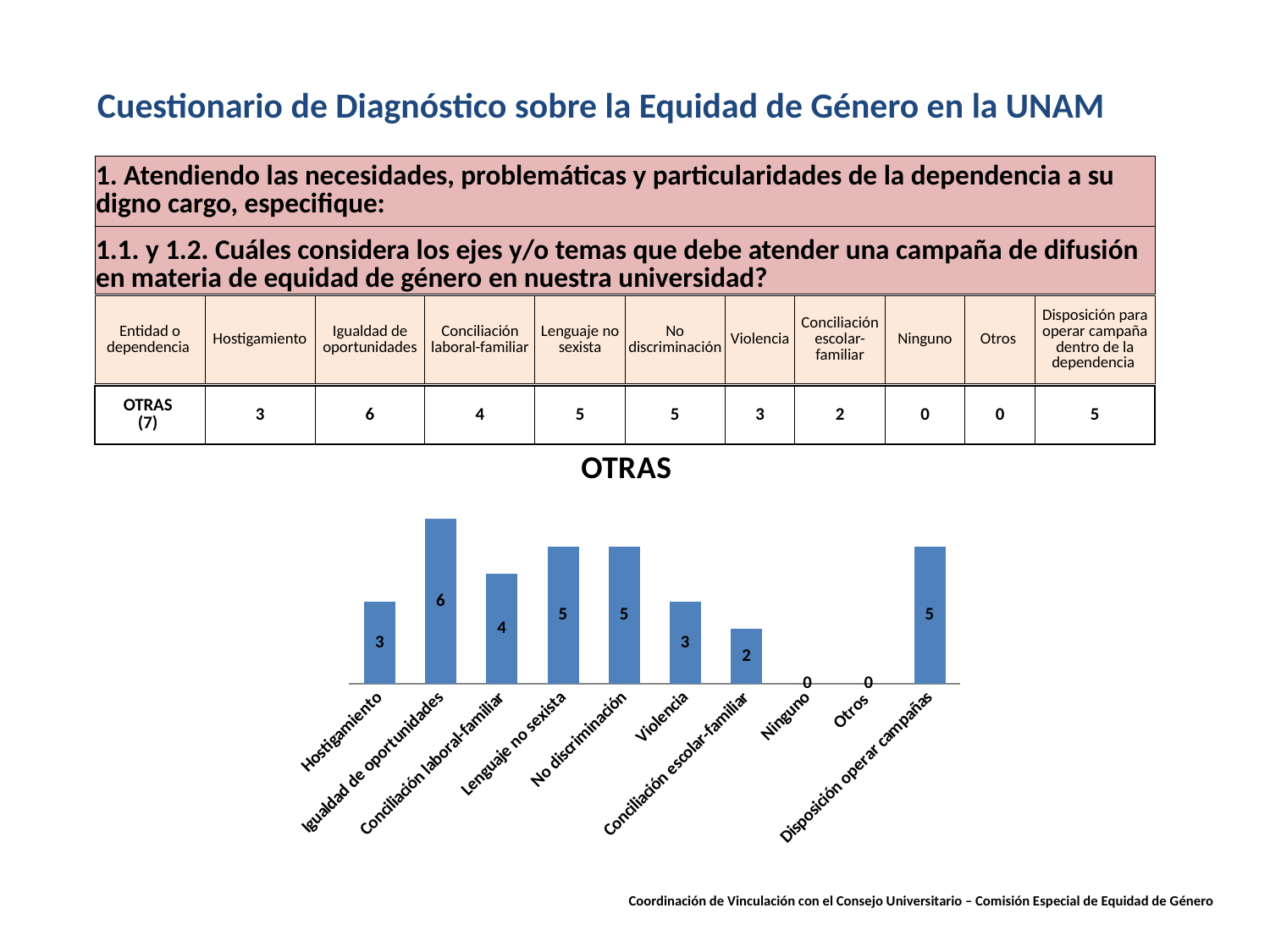
What is the value for Igualdad de oportunidades in the OTRAS chart? 6 How many categories are plotted in the OTRAS chart? 10 How many categories in the OTRAS chart have a value of 0? 2 What is the difference between the values for Igualdad de oportunidades and Violencia in the OTRAS chart? 3 What is the title of the chart on the slide? OTRAS What kind of chart is the OTRAS chart? Bar chart Which category has the highest value in the OTRAS chart? Igualdad de oportunidades What is the value for Disposición operar campañas in the OTRAS chart? 5 What is the value for Conciliación laboral-familiar in the OTRAS chart? 4 What is the value for Conciliación escolar-familiar in the OTRAS chart? 2 What is the value for Hostigamiento in the OTRAS chart? 3 Which is larger in the OTRAS chart, Lenguaje no sexista or Conciliación laboral-familiar? Lenguaje no sexista